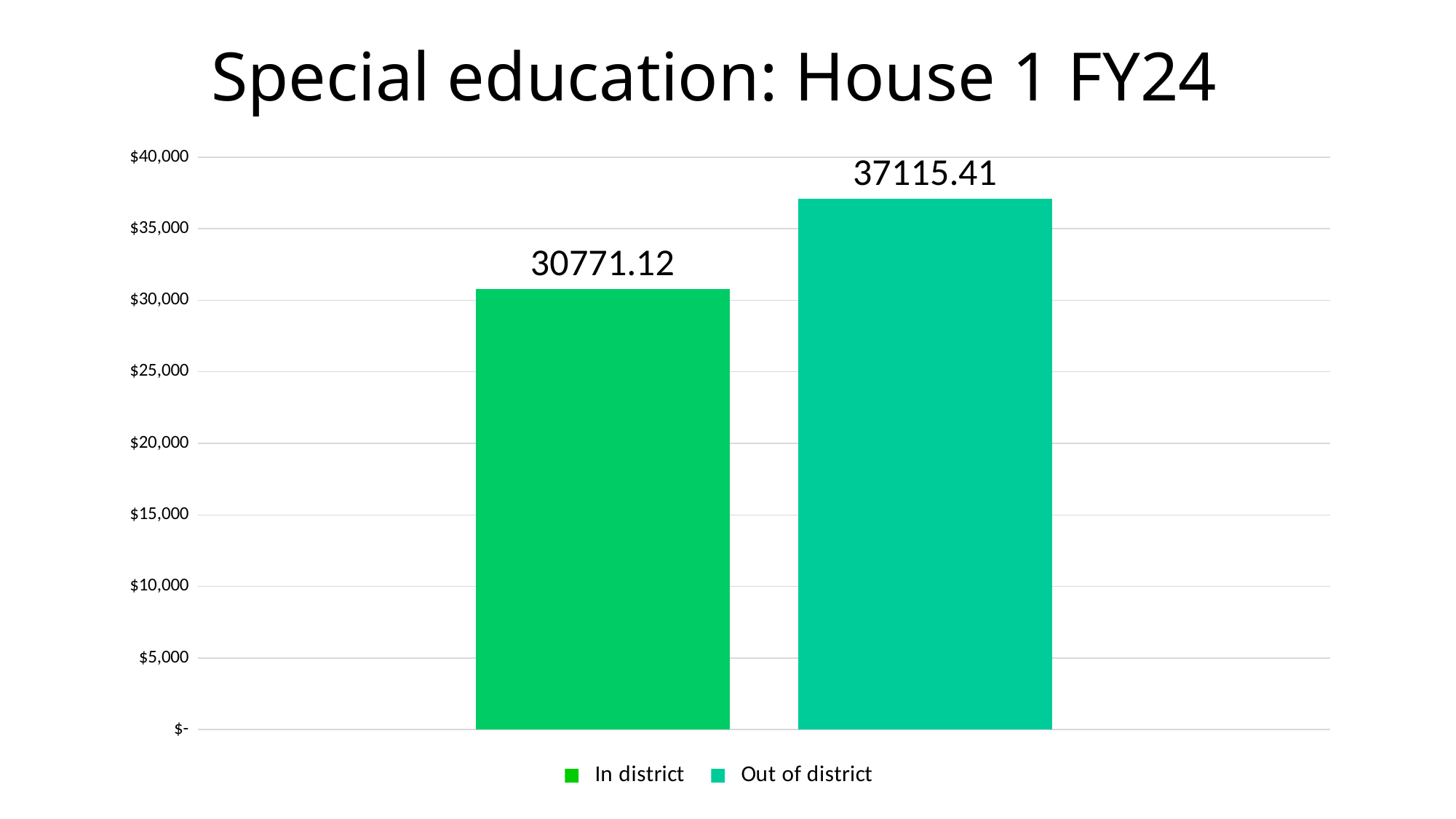
What is the value for Out of district? 37115.41 How many bars are plotted on the chart? 2 Is the value for In district greater or less than $35,000? less Which series has the higher value, In district or Out of district? Out of district How many series does the legend list? 2 What kind of chart is shown on the slide? bar chart What is the highest value shown on the vertical axis? $40,000 Which series has the lower value? In district What is the difference between the Out of district and In district values? 6344.29 What is the title of the slide? Special education: House 1 FY24 What is the value for In district? 30771.12 Is the value for Out of district greater or less than $35,000? greater